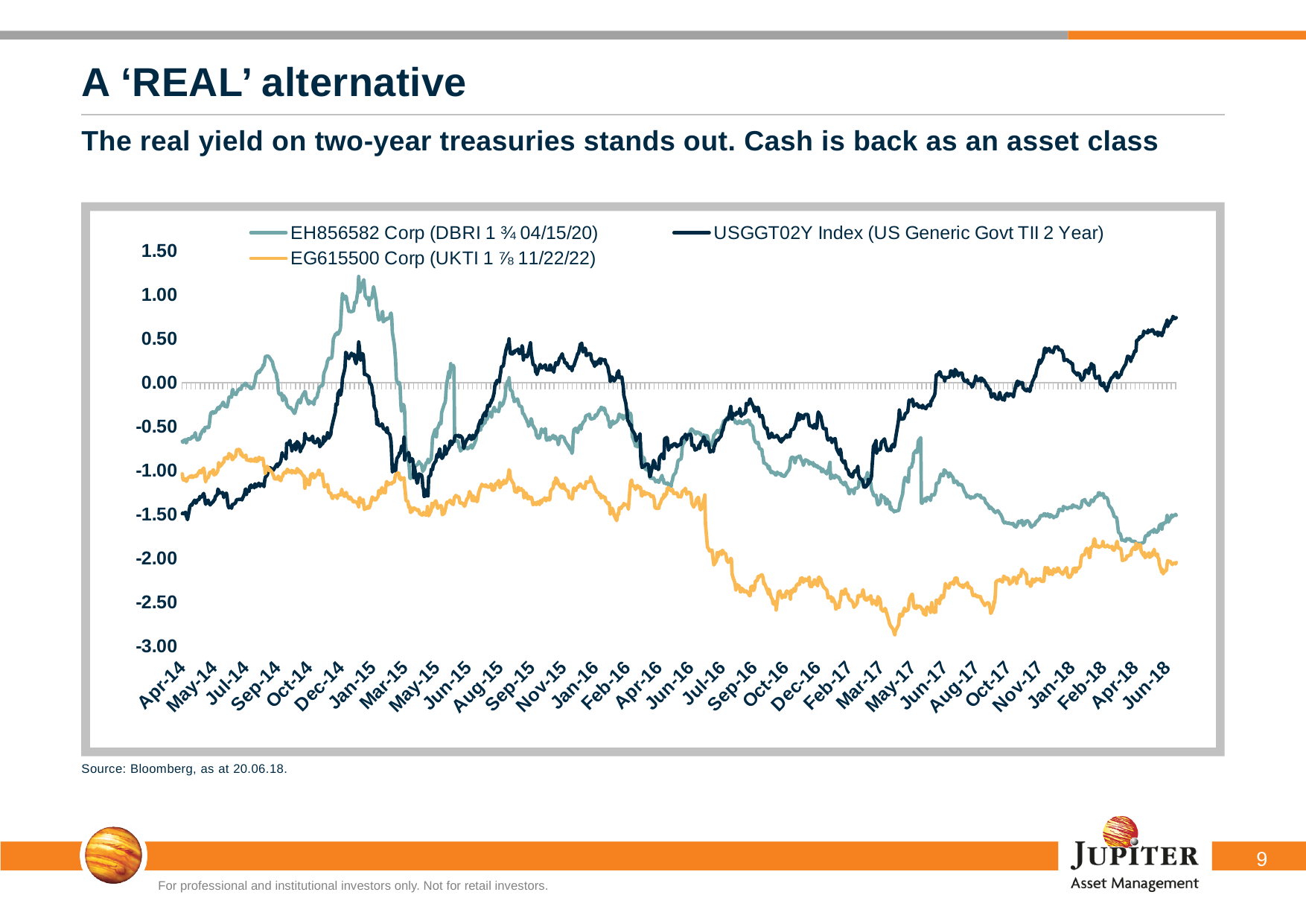
At Jun-18, which series has the lowest value? EG615500 Corp (UKTI 1 ⅞ 11/22/22) Does EG615500 Corp (UKTI 1 ⅞ 11/22/22) rise or fall between Jun-16 and Sep-16? Fall Is the value of the USGGT02Y Index at Apr-14 greater or less than -1.00? less Is the peak value of EH856582 Corp (DBRI 1 ¾ 04/15/20) around Jan-15 greater or less than 1.00? greater What kind of chart is shown on the slide? Line chart Which series is plotted with the dark navy line? USGGT02Y Index (US Generic Govt TII 2 Year) According to the note below the chart, what is the data source and as-at date? Bloomberg, as at 20.06.18 How many series does the chart's legend list? 3 At Jun-18, which series has the highest value? USGGT02Y Index (US Generic Govt TII 2 Year) Does the USGGT02Y Index generally rise or fall between Jan-18 and Jun-18? Rise Is the value of the USGGT02Y Index at Jun-18 greater or less than 0.50? greater